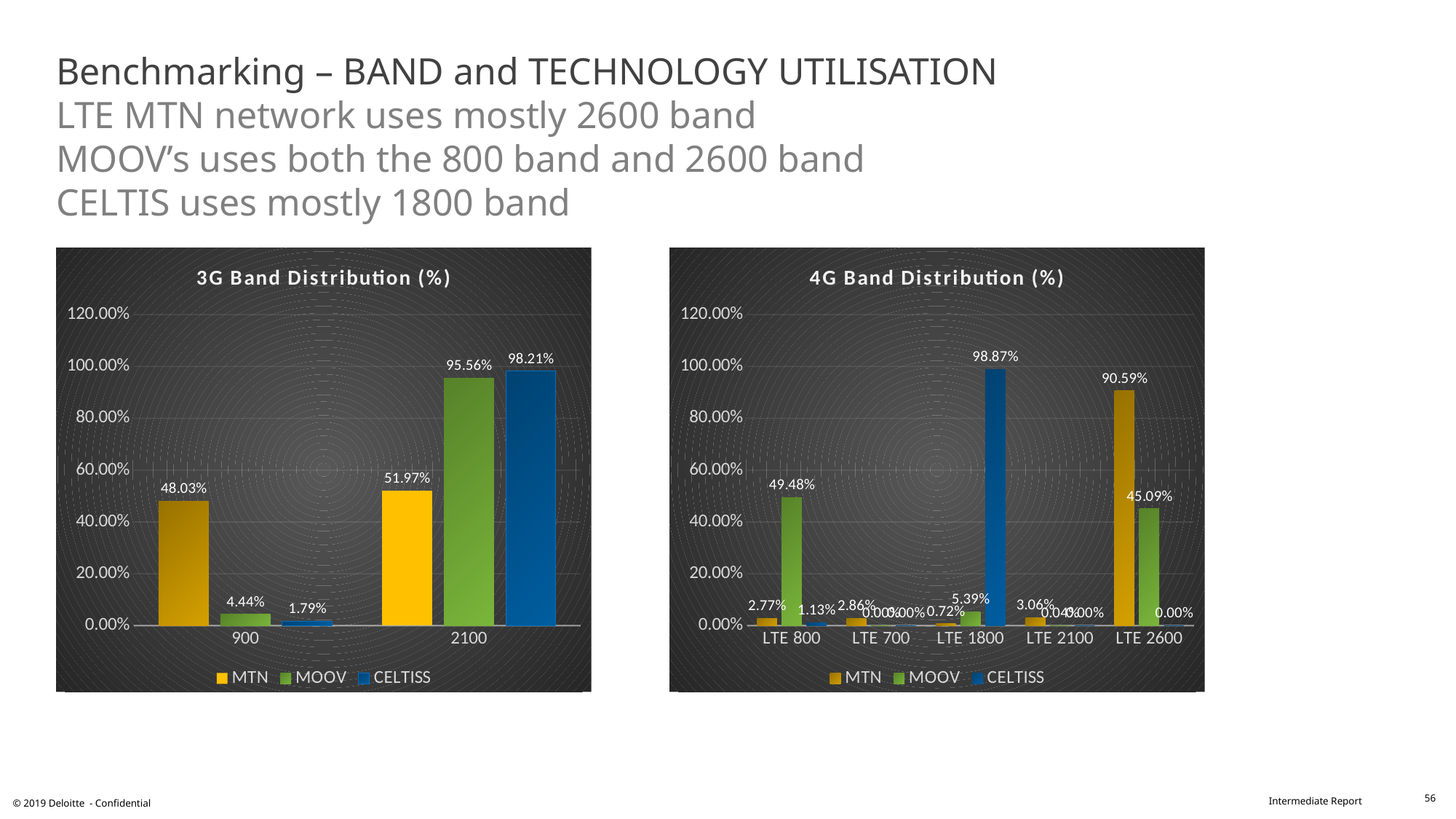
In the 4G Band Distribution (%) chart, what is the difference between MTN and MOOV in LTE 2600? 45.50% In the 4G Band Distribution (%) chart, how many series does the legend list? 3 In the 3G Band Distribution (%) chart, how many band categories are shown on the x axis? 2 In the 4G Band Distribution (%) chart, what is the value for MOOV in LTE 800? 49.48% In the 3G Band Distribution (%) chart, what is the difference between MTN's 2100 value and its 900 value? 3.94% In the 4G Band Distribution (%) chart, which band has the highest value for MTN? LTE 2600 In the 3G Band Distribution (%) chart, what is the value for CELTISS in the 2100 band? 98.21% In the 4G Band Distribution (%) chart, what is the value for CELTISS in LTE 1800? 98.87% In the 3G Band Distribution (%) chart, what is the value for MTN in the 900 band? 48.03% In the 3G Band Distribution (%) chart, which series has the highest value in the 2100 band? CELTISS In the 4G Band Distribution (%) chart, which is larger in LTE 2600: MTN or MOOV? MTN What type of chart is the 4G Band Distribution (%) chart? Bar chart